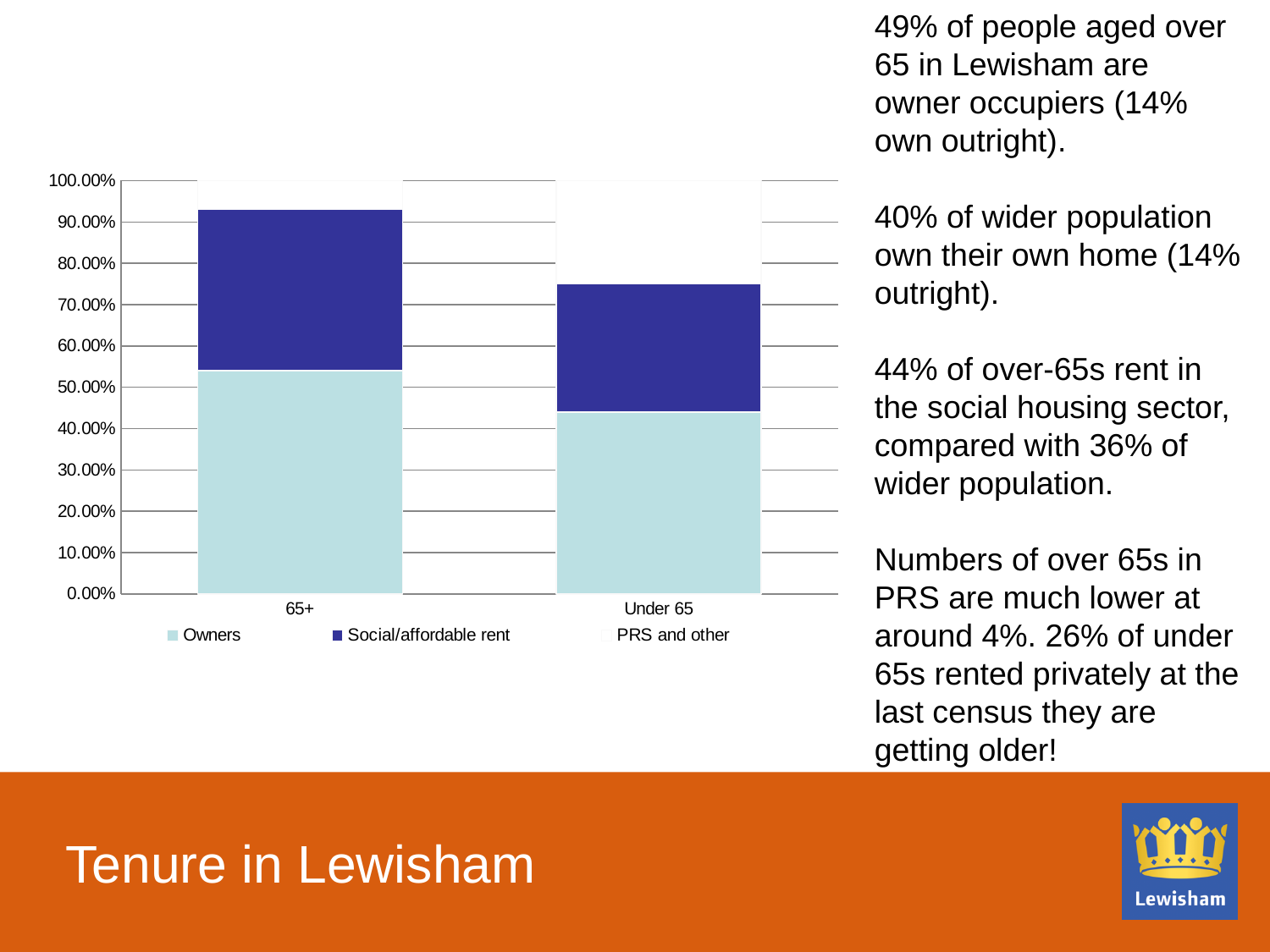
Which category has the larger Owners share, 65+ or Under 65? 65+ Which category has the lowest Owners value? Under 65 Is the Owners value for Under 65 greater or less than 50.00%? less How many series does the chart's legend list? 3 Is the Owners value for 65+ greater or less than 50.00%? greater How many categories are shown on the x axis of the chart? 2 What colour represents the Owners series in the chart? Light blue Is the top of the Social/affordable rent segment for 65+ greater or less than 90.00%? greater What kind of chart is shown on the slide? Stacked bar chart What are the three series listed in the chart's legend? Owners, Social/affordable rent, PRS and other Which category has the larger Owners plus Social/affordable rent combined height? 65+